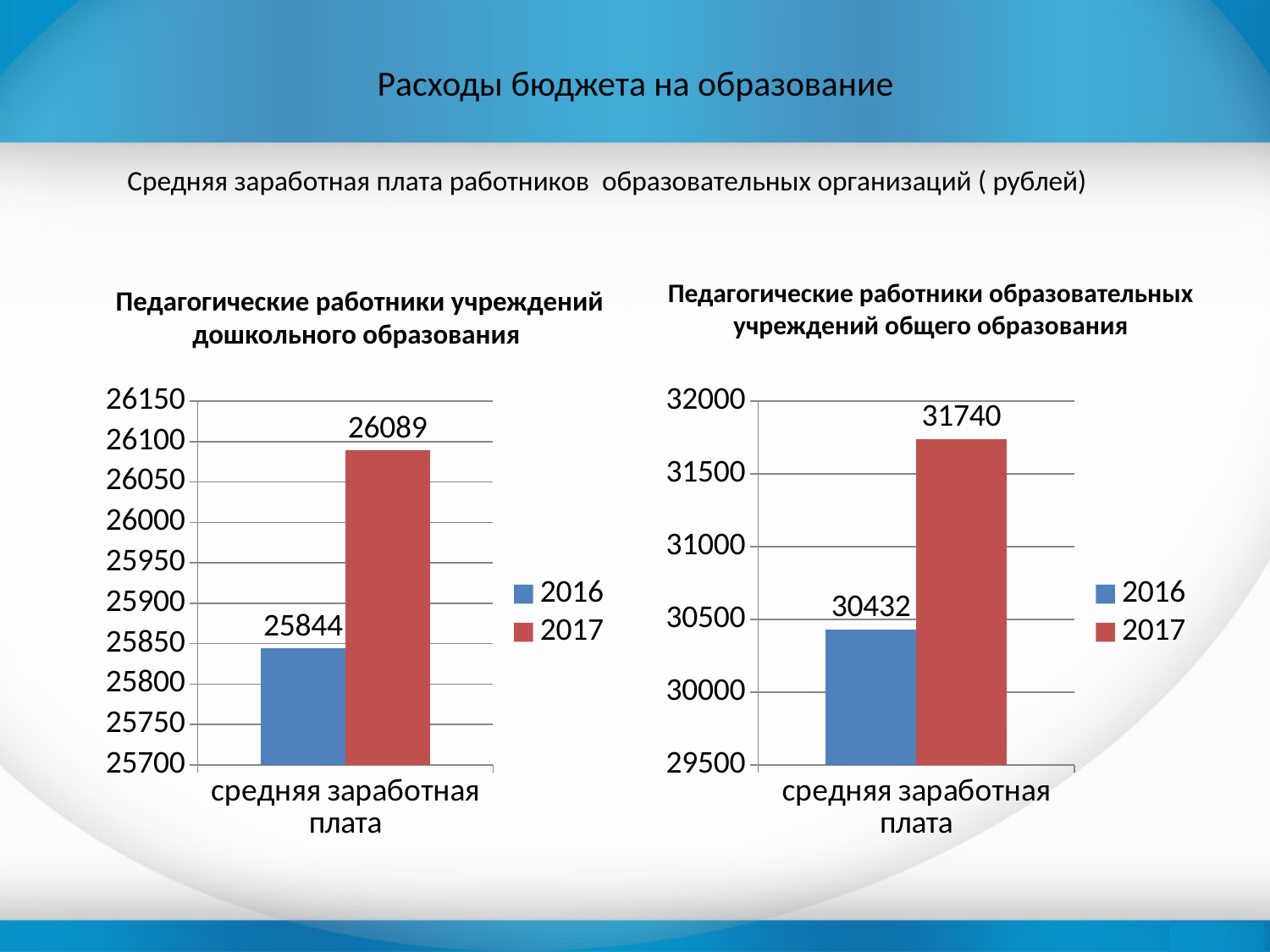
In the right chart, is the value for 2016 greater or less than 30500? less In the left chart, what is the difference between the 2017 and 2016 values? 245 In the right chart, which series has the lower value, 2016 or 2017? 2016 In the right chart (Педагогические работники образовательных учреждений общего образования), what is the value for 2016? 30432 In the left chart, which colour represents the 2017 series? Red In the left chart (Педагогические работники учреждений дошкольного образования), what is the value for 2016? 25844 What kind of chart is the left chart? Bar chart In the right chart (Педагогические работники образовательных учреждений общего образования), what is the value for 2017? 31740 In the left chart, which series has the higher value, 2016 or 2017? 2017 How many series does the legend of the right chart list? 2 In the right chart, what is the difference between the 2017 and 2016 values? 1308 In the left chart (Педагогические работники учреждений дошкольного образования), what is the value for 2017? 26089